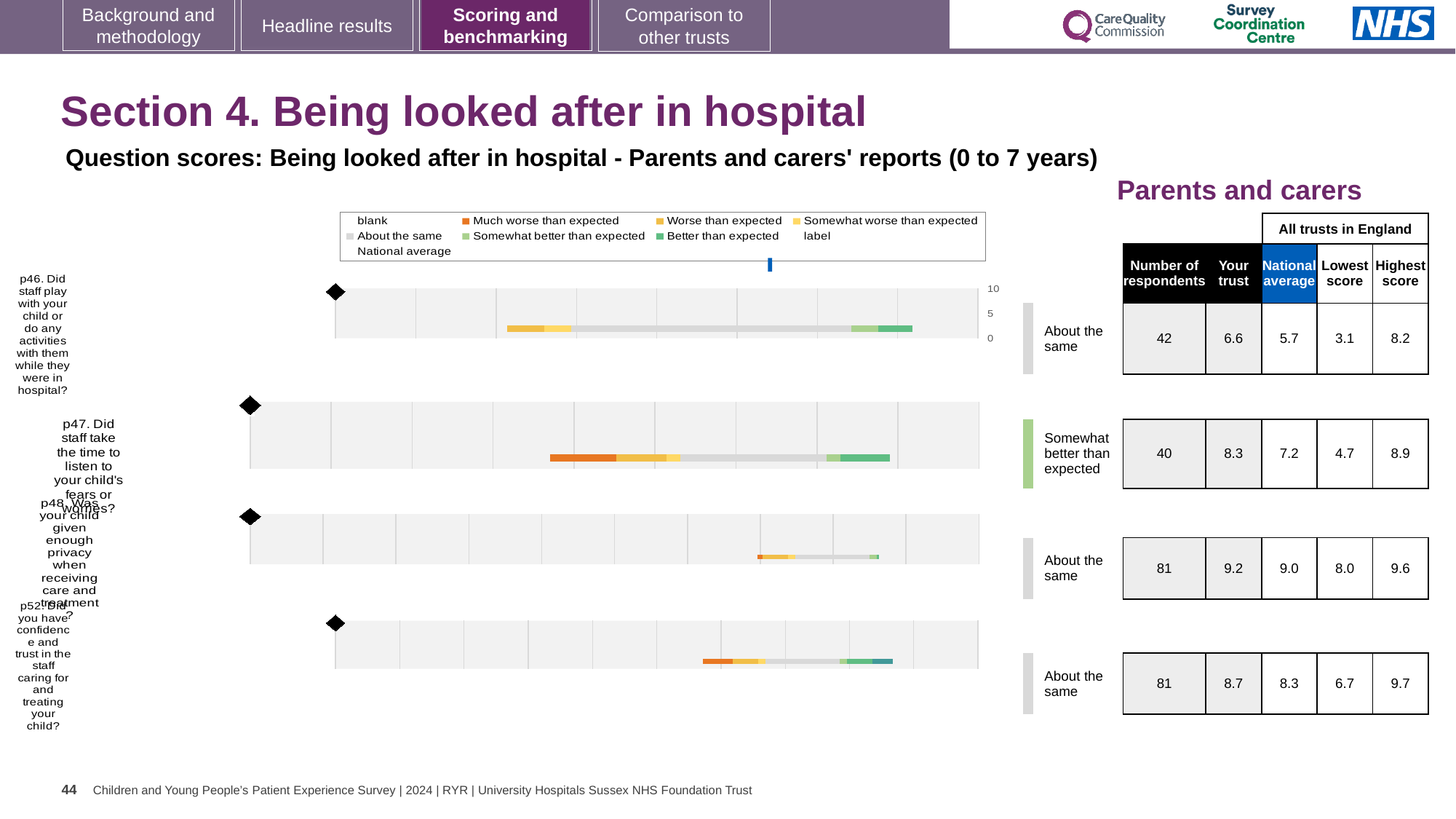
In the chart legend, which category is shown in orange? Much worse than expected What is the 'Your trust' score shown for p46 (Did staff play with your child or do any activities with them while they were in hospital?)? 6.6 What is the highest score across all trusts in England shown for p52? 9.7 For p47, what is the difference between the 'Your trust' score and the national average? 1.1 Which question has the highest 'Your trust' score? p48 How many respondents are shown for p48 (Was your child given enough privacy when receiving care and treatment?)? 81 For p52, which is larger: the 'Your trust' score or the national average? Your trust What benchmark category is shown next to the chart for p47? Somewhat better than expected How many question bar charts are shown on the slide? 4 Which question has the lowest 'Your trust' score? p46 What kind of chart is used to show the benchmarking results for question p46? bar chart What is the national average shown for p47 (Did staff take the time to listen to your child's fears or worries?)? 7.2